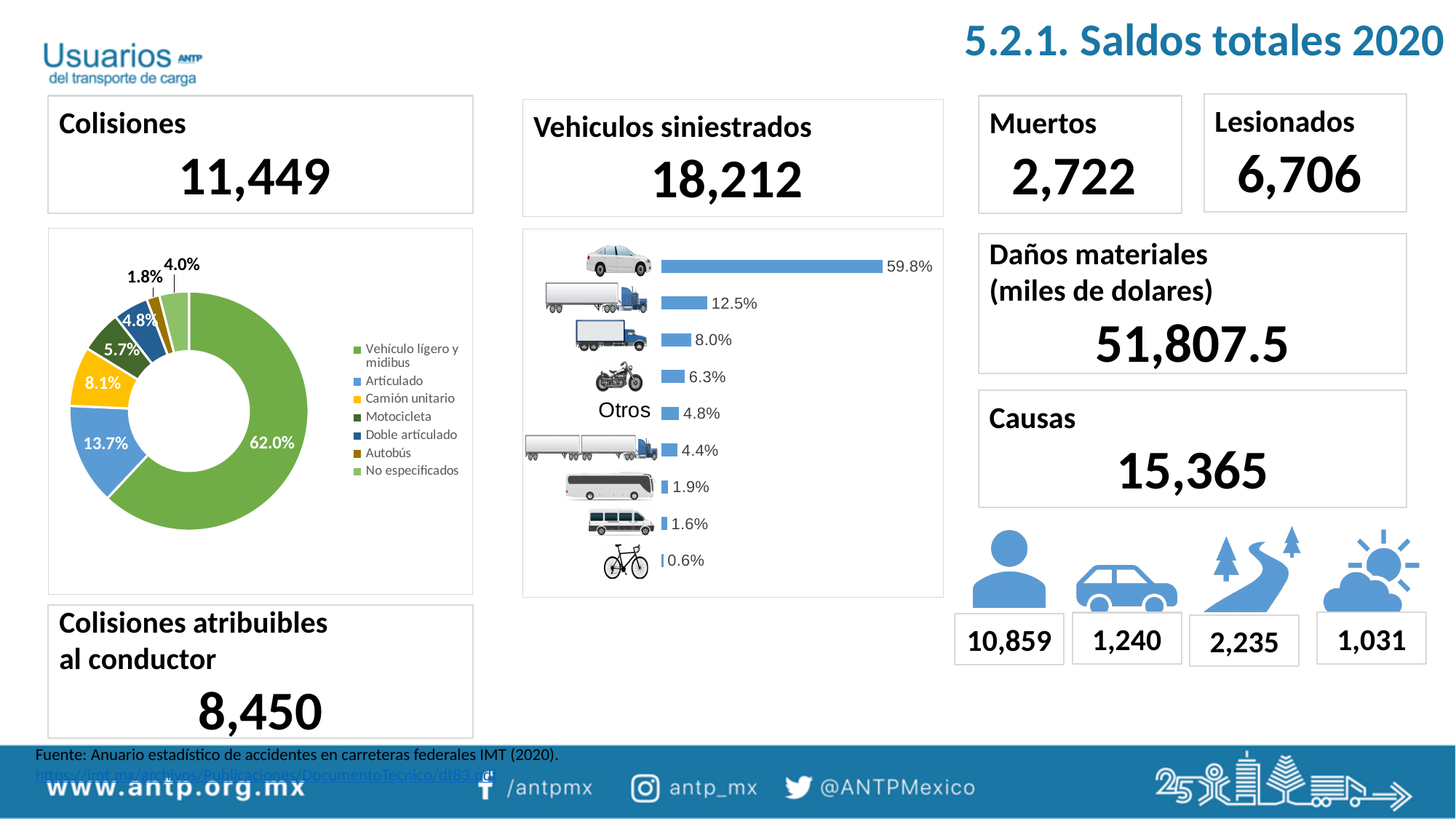
In the donut chart on the left, what share is shown for Camión unitario? 8.1% In the donut chart on the left, what is the difference between the shares for Motocicleta and Doble articulado? 0.9% In the donut chart on the left, what share is shown for Vehículo lígero y midibus? 62.0% In the bar chart in the middle panel, what is the value of the longest bar? 59.8% How many bars are plotted in the bar chart in the middle panel? 9 In the bar chart in the middle panel, what value is shown for Otros? 4.8% In the donut chart on the left, what share is shown for Articulado? 13.7% In the donut chart on the left, which category has the largest share? Vehículo lígero y midibus How many categories does the legend of the donut chart on the left list? 7 In the donut chart on the left, which category has the smallest share? Autobús What type of chart is shown in the middle panel under Vehiculos siniestrados? Bar chart In the donut chart on the left, which is larger: the share for Camión unitario or the share for No especificados? Camión unitario